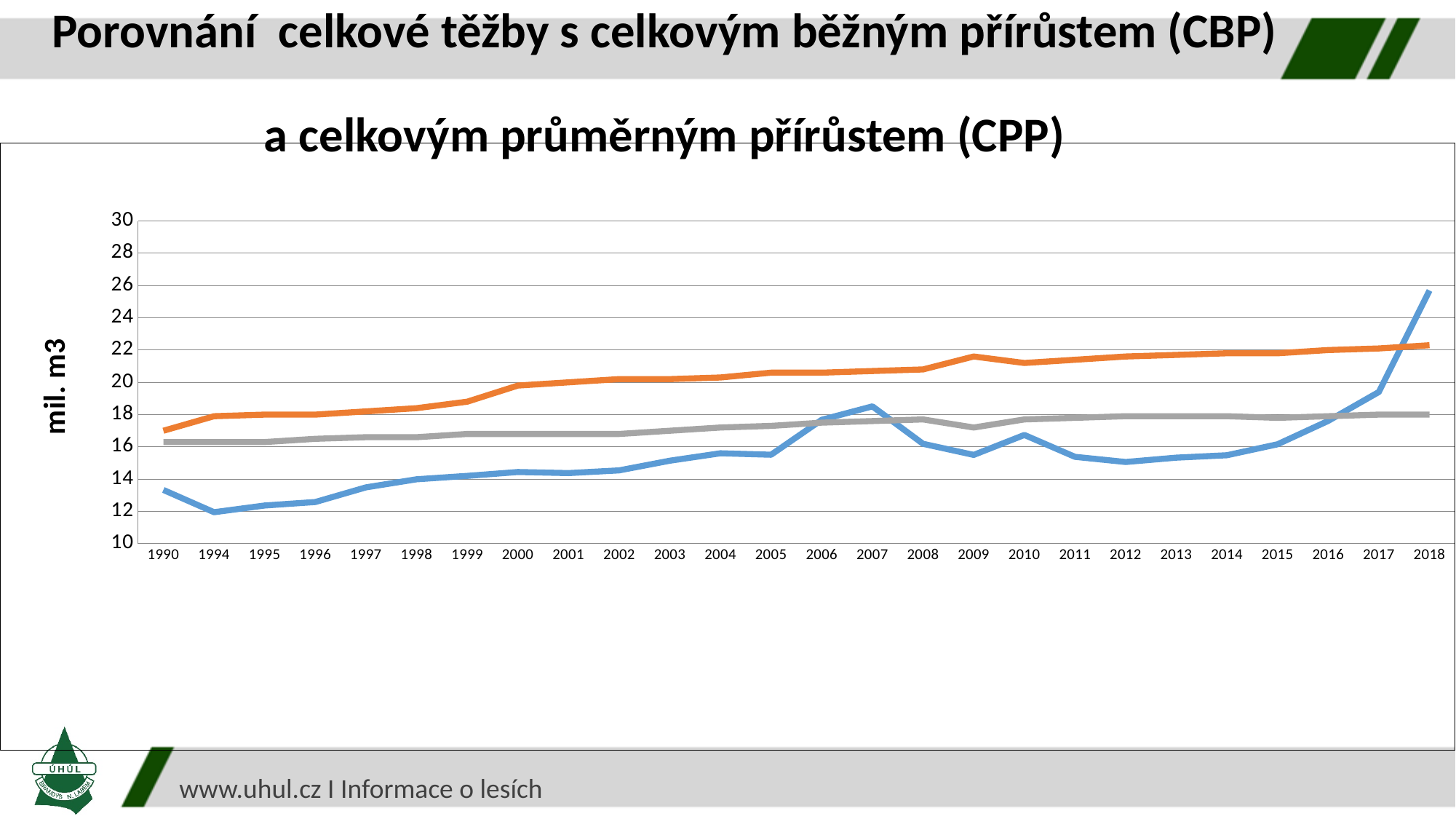
Is the value of the blue line in 2018 greater or less than 24? greater What is the label of the vertical axis of the chart? mil. m3 How many years are labelled along the x axis of the chart? 26 In 2018, which line has the higher value, the blue line or the orange line? the blue line In which year does the blue line reach its lowest value? 1994 In which year does the blue line reach its highest value? 2018 Does the orange line generally rise or fall from 1990 to 2018? rise What is the first year shown on the x axis of the chart? 1990 What kind of chart is shown on the slide? line chart Is the value of the grey line in 2018 greater or less than 20? less Is the value of the blue line in 1994 greater or less than 14? less